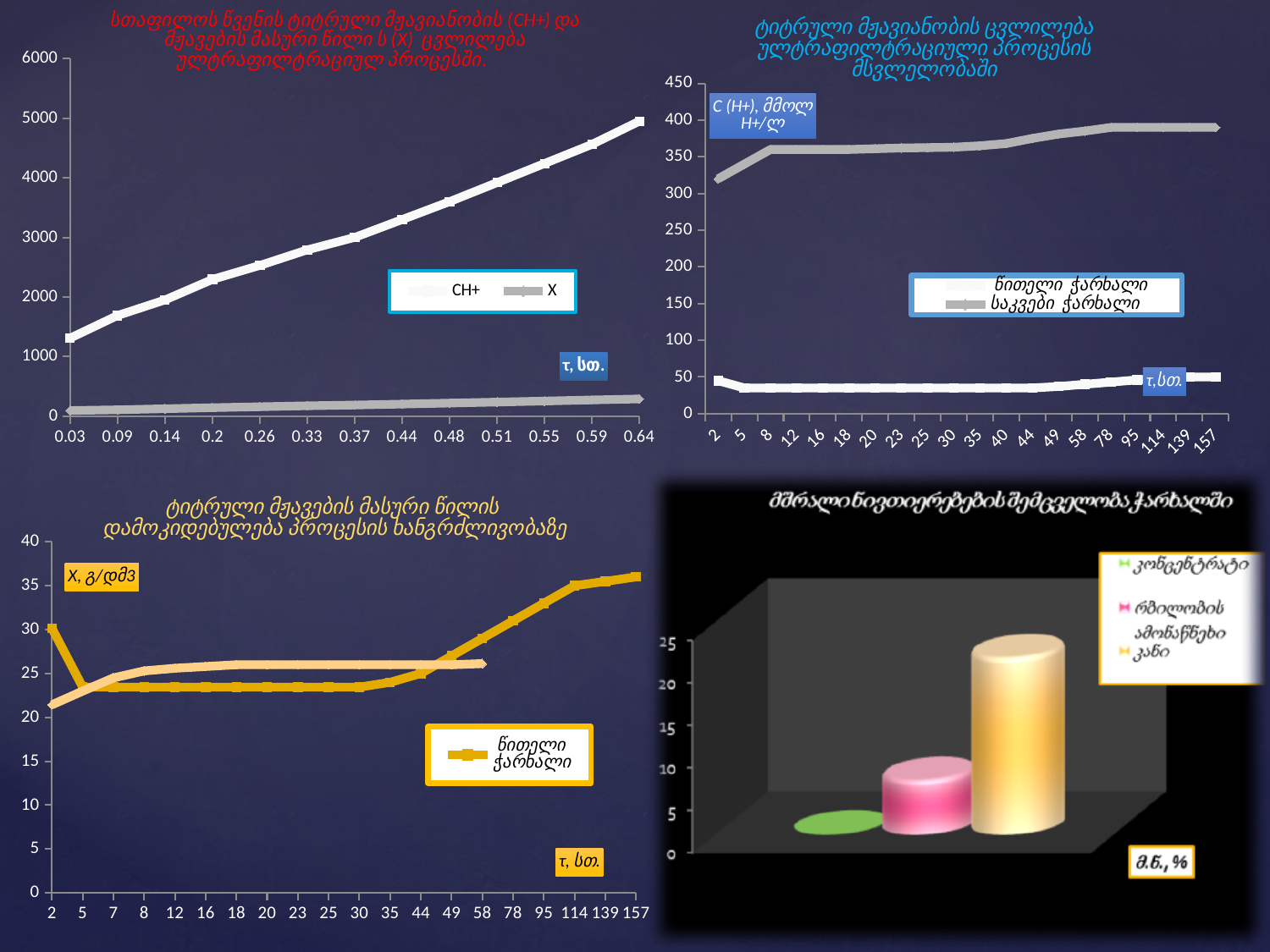
What kind of chart is the bottom-right chart? bar chart How many τ values are shown on the x axis of the top-right chart? 20 In the top-right chart, which series has the higher values throughout, წითელი ჭარხალი or საკვები ჭარხალი? საკვები ჭარხალი In the top-left chart, which series has the larger value at τ = 0.44, CH+ or X? CH+ In the top-left chart, does the CH+ series rise or fall as τ increases from 0.03 to 0.64? rises In the bottom-right chart, which category has the highest value? კანი What kind of chart is the top-left chart? line chart What are the two legend entries of the top-left chart? CH+ and X In the top-left chart, is the CH+ value at τ = 0.64 greater or less than 4000? greater How many series does the legend of the top-left chart list? 2 In the top-right chart, is the value of the grey series (საკვები ჭარხალი) at τ = 2 greater or less than 300? greater In the bottom-left chart, is the value of the yellow წითელი ჭარხალი series at τ = 157 greater or less than 30? greater